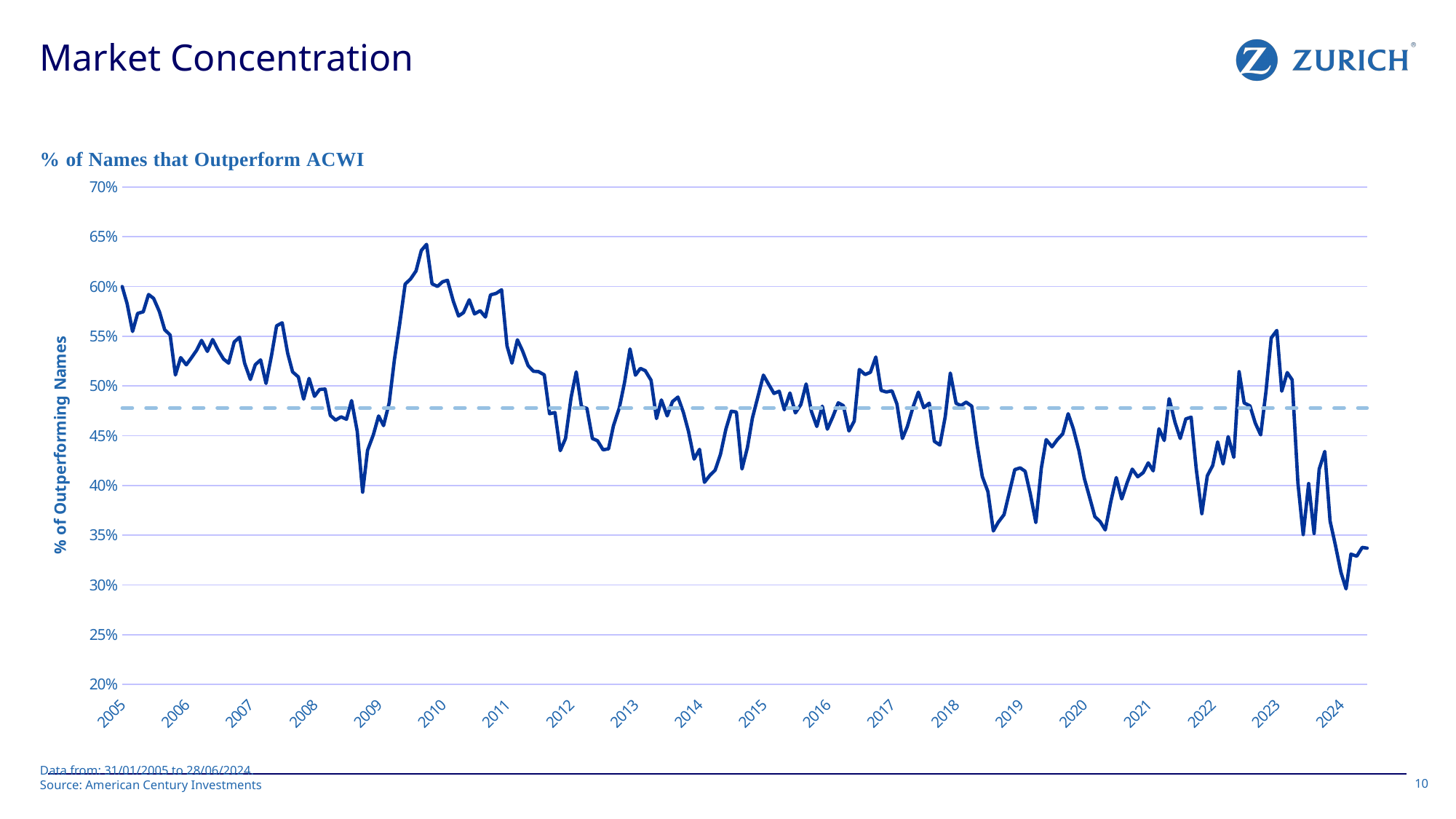
In which year does the line reach its lowest point? 2024 Is the value at the start of 2005 greater or less than 55%? greater Is the dip in the line around early 2009 greater or less than 45%? less How many year labels are shown on the x axis? 20 Is the horizontal dashed line greater or less than 50%? less Which is larger, the value at the start of 2005 or the value at the end of the series in 2024? start of 2005 What is the label on the y axis of the chart? % of Outperforming Names What is the title of the chart? % of Names that Outperform ACWI What kind of chart is shown on the slide? line chart Overall, does the line rise or fall from 2005 to 2024? fall